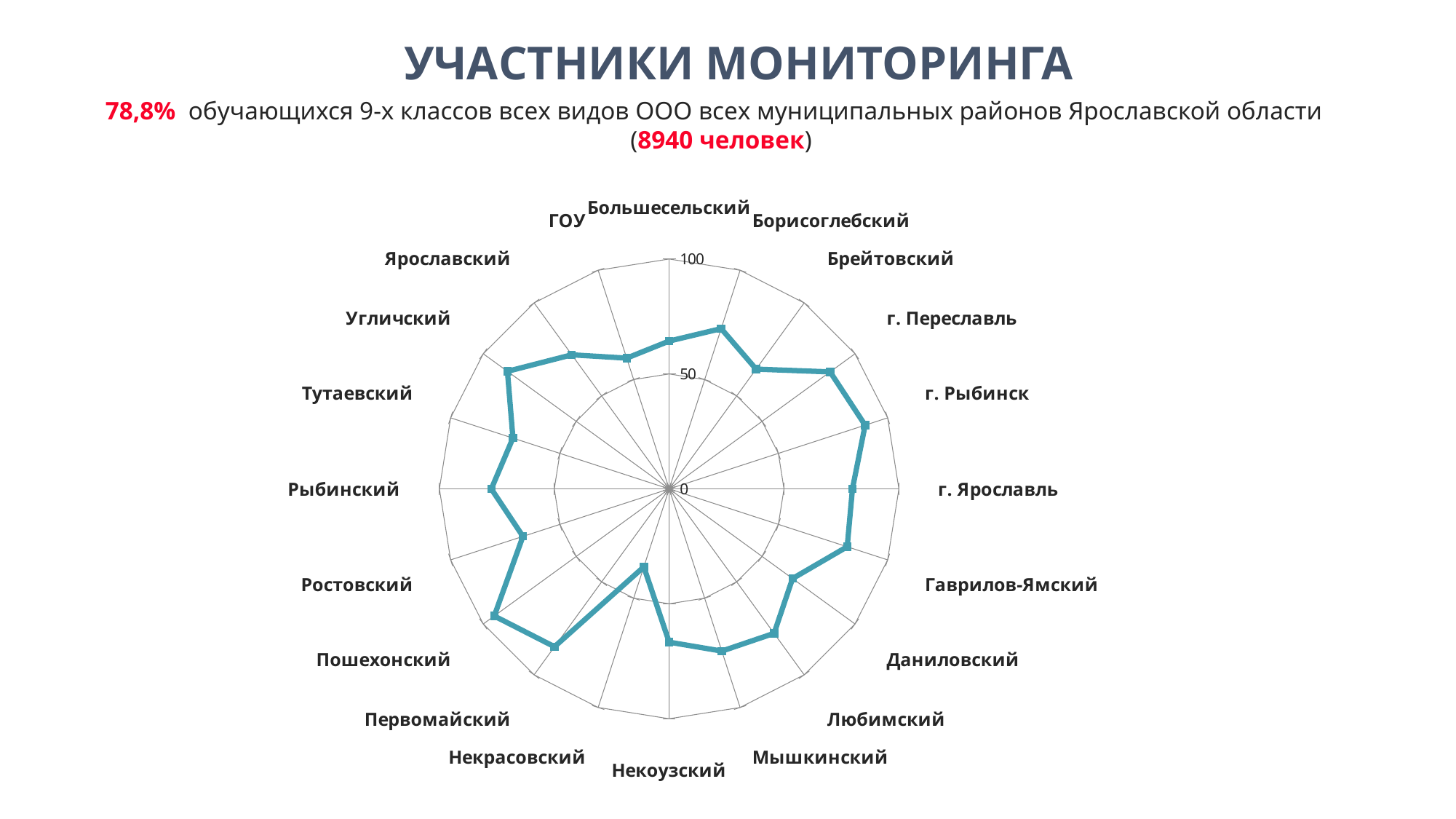
How many categories (districts) are plotted on the radar chart? 20 Which category has the lowest value on the radar chart? Некрасовский Is the value for Большесельский greater or less than 50? greater Is the value for г. Рыбинск greater or less than 50? greater Which is larger, the value for Пошехонский or the value for Некоузский? Пошехонский What is the title of the slide containing the chart? УЧАСТНИКИ МОНИТОРИНГА What is the maximum value shown on the radar chart's axis scale? 100 Is the value for Пошехонский greater or less than 50? greater What kind of chart is shown on the slide? radar chart Which is larger, the value for г. Рыбинск or the value for Некоузский? г. Рыбинск